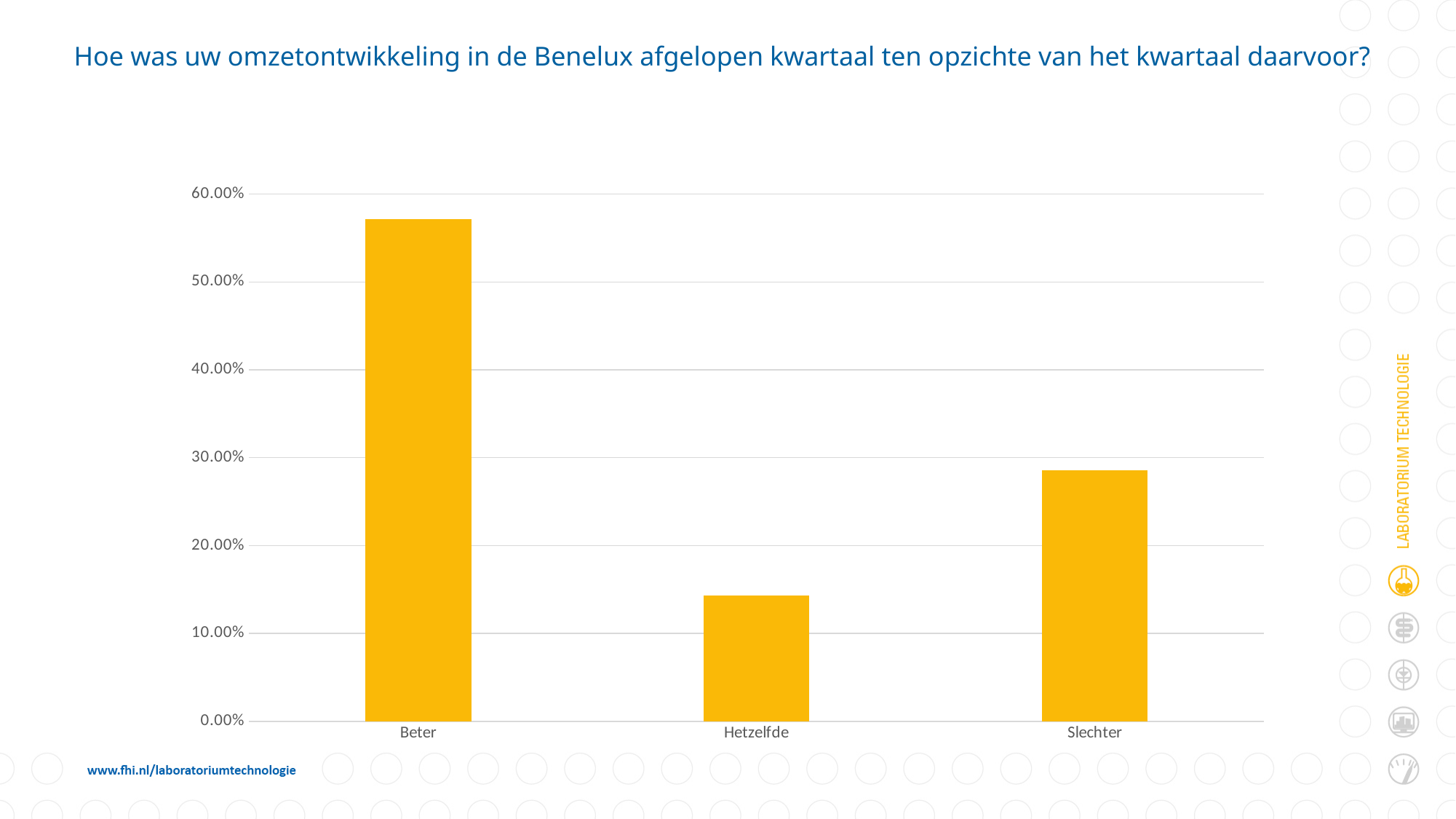
What is the title of the chart? Hoe was uw omzetontwikkeling in de Benelux afgelopen kwartaal ten opzichte van het kwartaal daarvoor? Which category has the highest value? Beter What kind of chart is shown on the slide? bar chart Is the value for Hetzelfde greater or less than 10.00%? greater Which is larger, the value for Beter or the value for Slechter? Beter Which is larger, the value for Slechter or the value for Hetzelfde? Slechter Is the value for Beter greater or less than 50.00%? greater What colour are the bars in the chart? yellow Is the value for Slechter greater or less than 30.00%? less Which category has the lowest value? Hetzelfde How many categories are shown on the x axis? 3